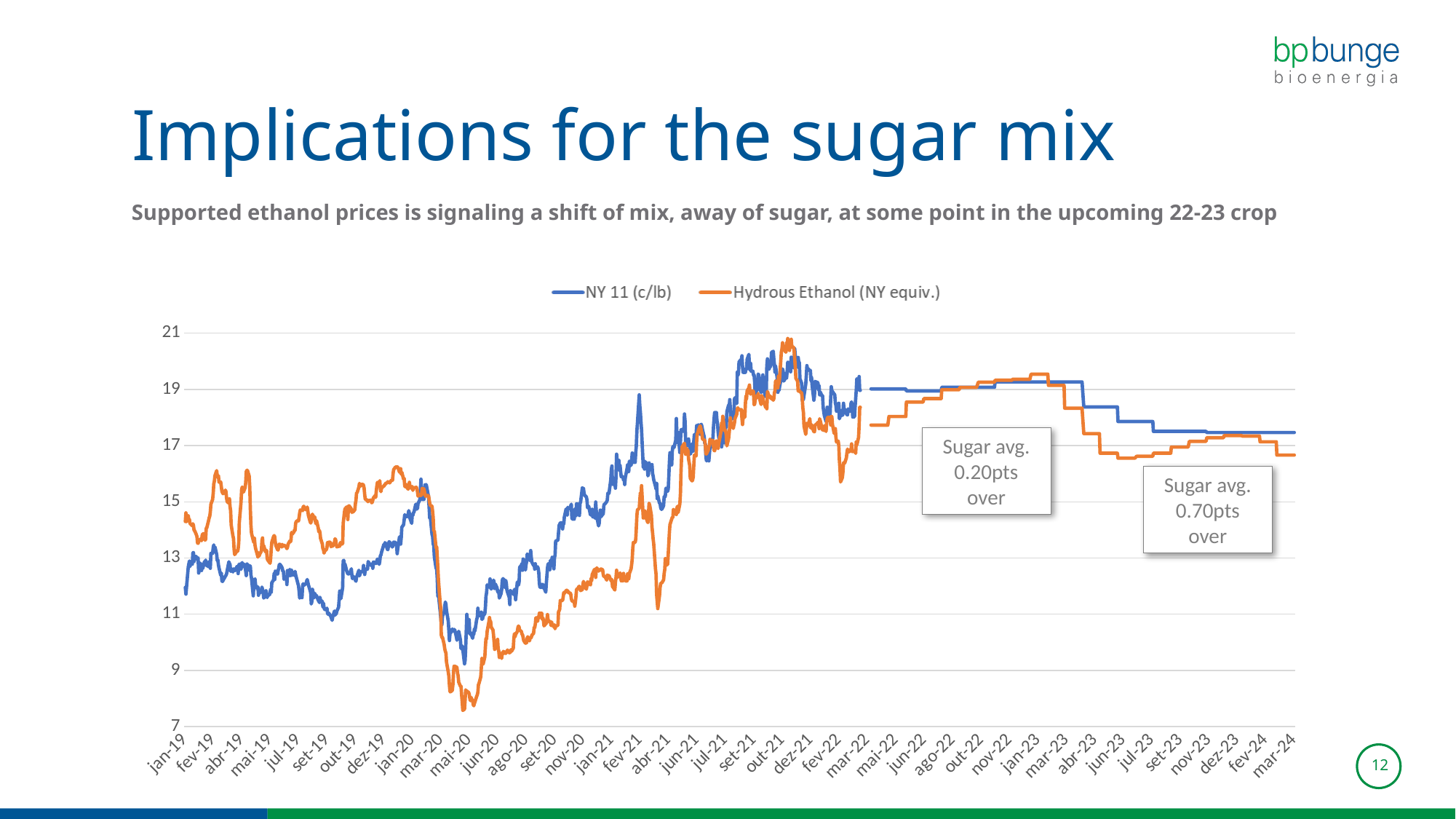
At mar-24, which series has the higher value, NY 11 (c/lb) or Hydrous Ethanol (NY equiv.)? NY 11 (c/lb) Is the value of Hydrous Ethanol (NY equiv.) at mar-24 greater or less than 19? less Is the value of Hydrous Ethanol (NY equiv.) around mai-20 greater or less than 9? less Is the value of NY 11 (c/lb) around mai-20 greater or less than 11? less What kind of chart is shown on the slide? Line chart Does the Hydrous Ethanol (NY equiv.) series rise or fall between jan-20 and mai-20? Fall At jan-19, which series has the higher value, NY 11 (c/lb) or Hydrous Ethanol (NY equiv.)? Hydrous Ethanol (NY equiv.) Does the NY 11 (c/lb) series rise or fall between mai-20 and out-21? Rise Which series is drawn in orange? Hydrous Ethanol (NY equiv.) According to the first annotation box on the chart, by how many points is sugar on average over? 0.20pts How many series does the legend list? 2